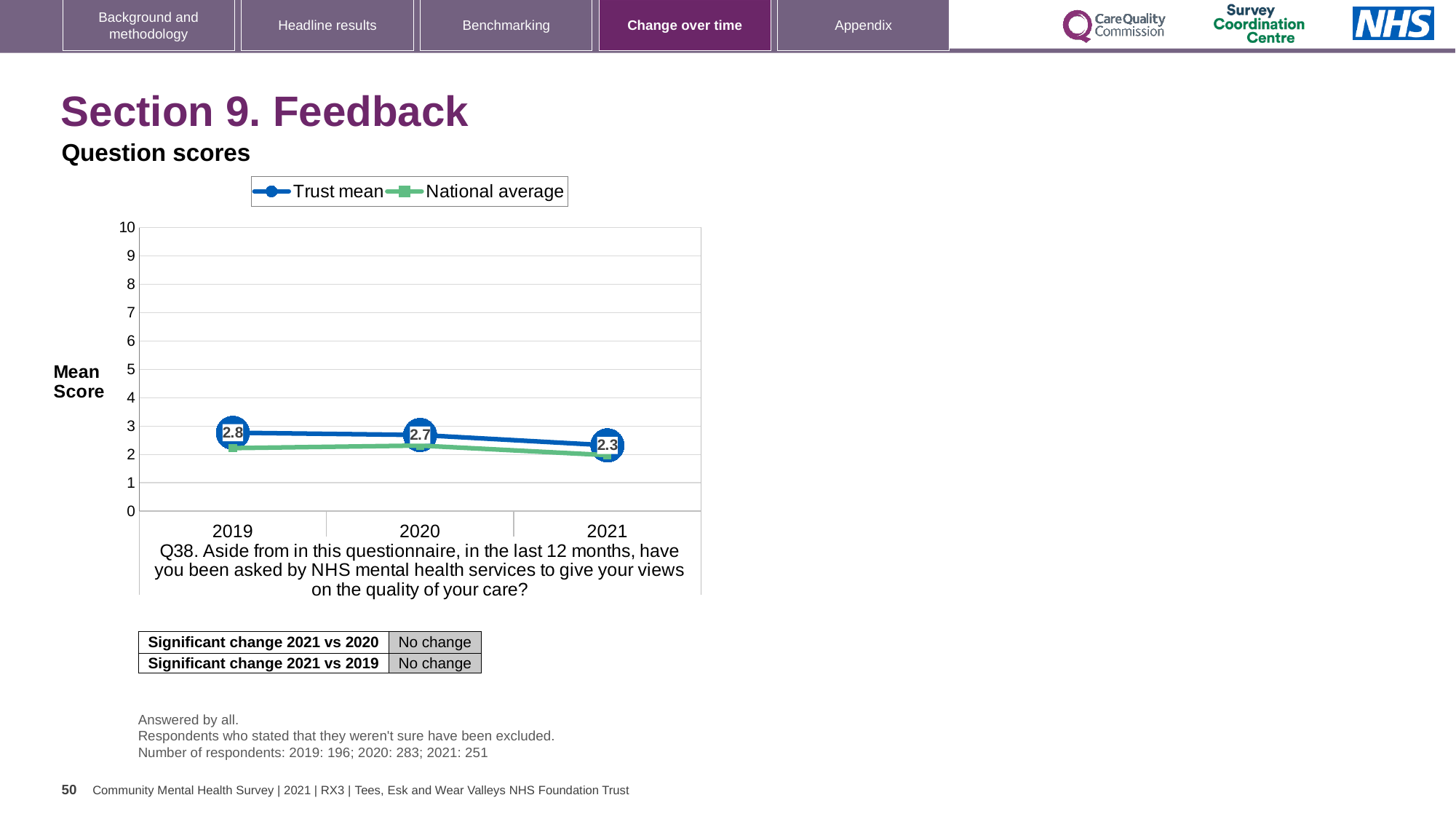
What is the Trust mean score for 2020? 2.7 In which year is the Trust mean score lowest? 2021 What is the Trust mean score for 2019? 2.8 What kind of chart is shown on the slide? Line chart In 2019, which is higher: the Trust mean or the National average? Trust mean What is the difference between the Trust mean score in 2020 and in 2021? 0.4 Is the National average value for 2020 greater or less than 3? less How many years are plotted on the x axis? 3 In which year is the Trust mean score highest? 2019 What is the difference between the Trust mean score in 2019 and in 2021? 0.5 What is the Trust mean score for 2021? 2.3 How many series does the legend list? 2